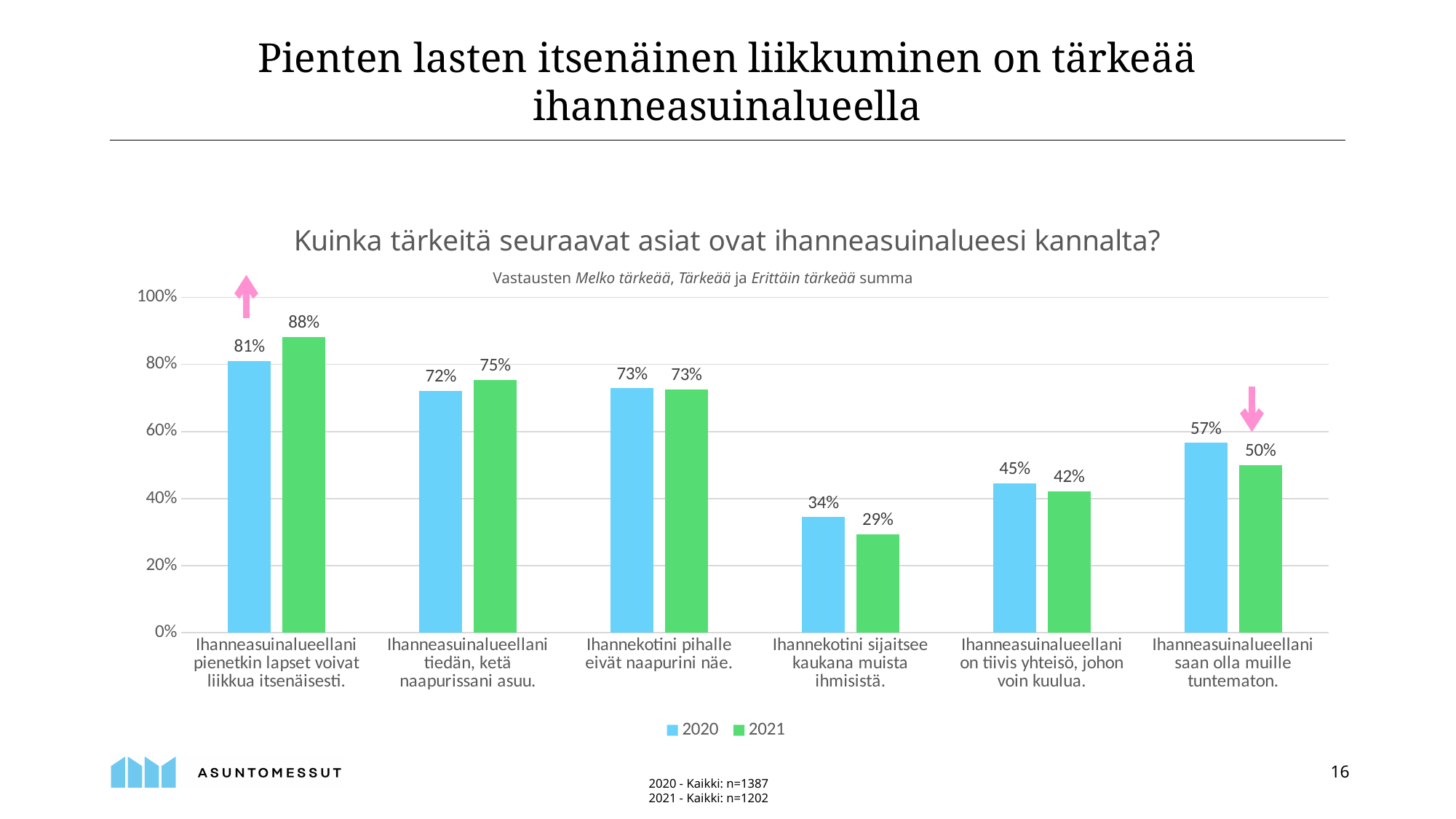
What is the difference between the 2021 and 2020 values for "Ihanneasuinalueellani pienetkin lapset voivat liikkua itsenäisesti."? 7 percentage points Which category has the highest 2021 value? Ihanneasuinalueellani pienetkin lapset voivat liikkua itsenäisesti. Which category has the lowest 2020 value? Ihannekotini sijaitsee kaukana muista ihmisistä. How many categories are shown on the x axis? 6 How many series does the legend list? 2 Is the 2021 value for "Ihannekotini sijaitsee kaukana muista ihmisistä." greater or less than 40%? less What is the 2021 value for "Ihanneasuinalueellani saan olla muille tuntematon."? 50% What is the difference between the 2020 and 2021 values for "Ihanneasuinalueellani saan olla muille tuntematon."? 7 percentage points Which is larger for "Ihanneasuinalueellani on tiivis yhteisö, johon voin kuulua.": the 2020 value or the 2021 value? 2020 What is the 2020 value for "Ihannekotini sijaitsee kaukana muista ihmisistä."? 34% What is the 2021 value for "Ihanneasuinalueellani pienetkin lapset voivat liikkua itsenäisesti."? 88% What kind of chart is shown on the slide? Bar chart